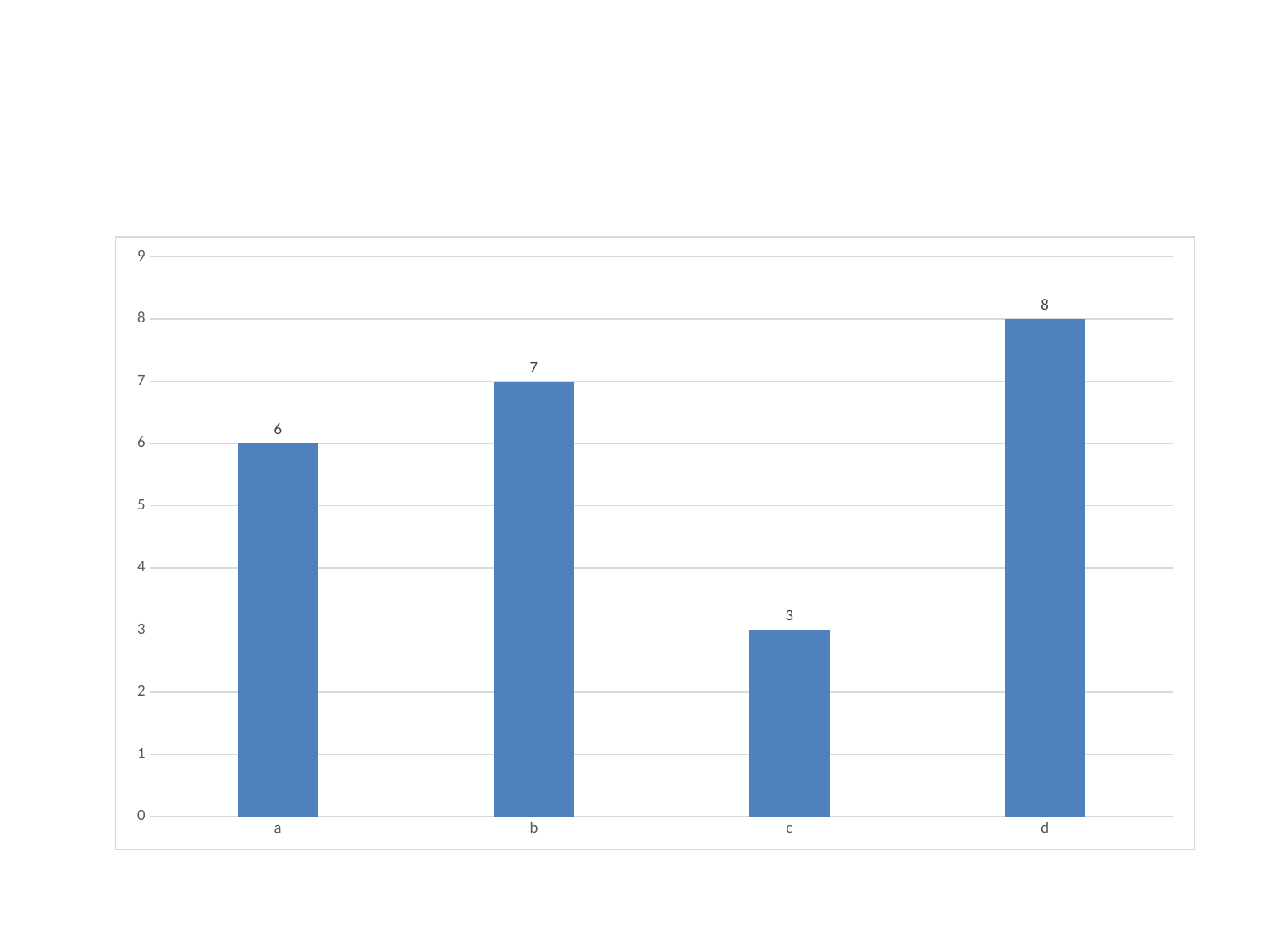
Which category has the lowest value? c What is the value for category d? 8 Which category has the highest value? d Which is larger, the value for a or the value for c? a What is the difference between the values for b and a? 1 What kind of chart is shown on the slide? bar chart How many categories are shown on the x axis? 4 Is the value for c greater or less than 5? less What is the value for category b? 7 What is the value for category a? 6 What is the value for category c? 3 What is the difference between the values for d and c? 5